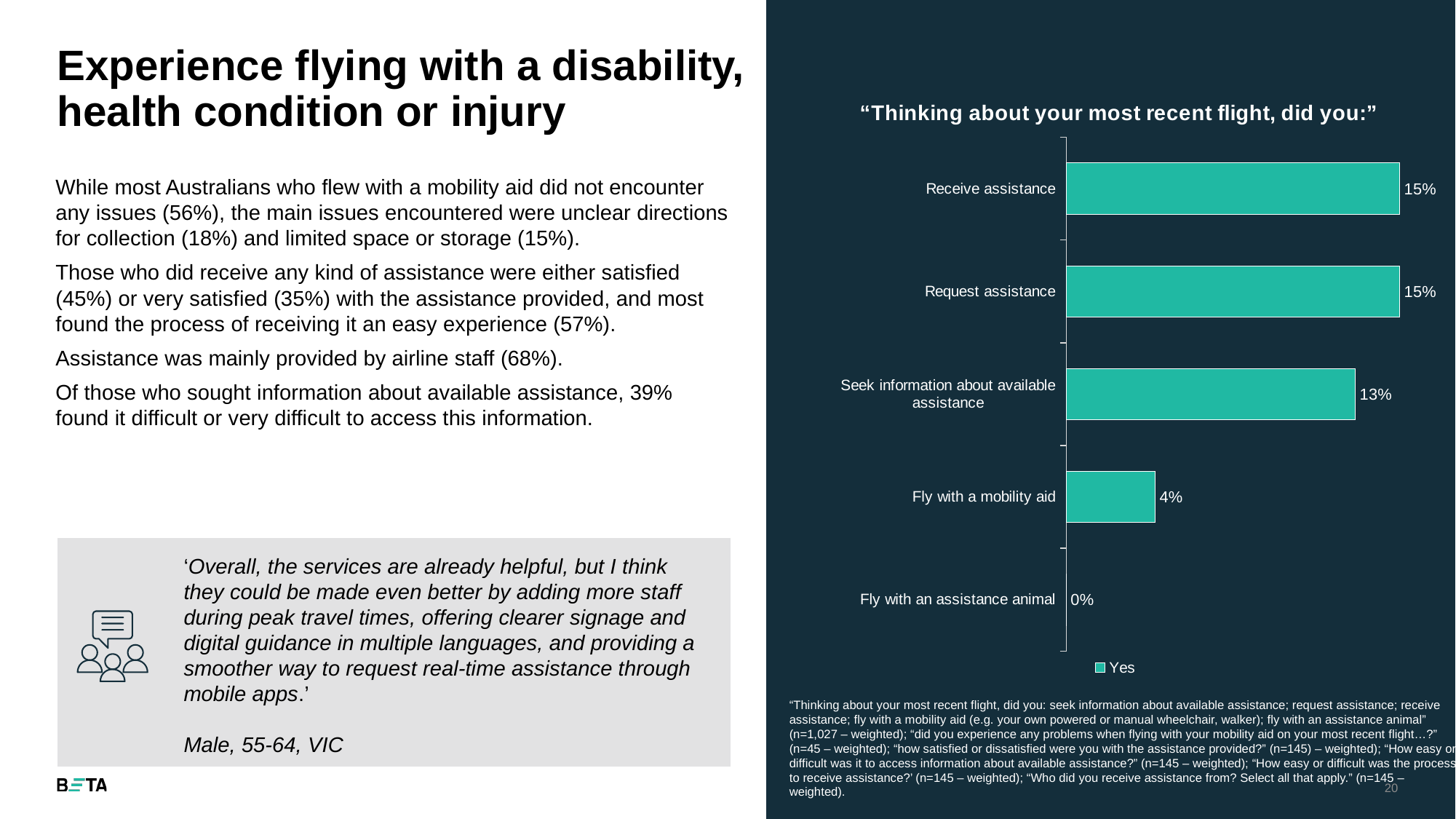
How many categories are shown in the chart? 5 What is the legend entry shown below the chart? Yes Which category has the lowest value in the chart? Fly with an assistance animal How many series does the legend list? 1 What is the difference between the values for 'Request assistance' and 'Fly with a mobility aid'? 11% What kind of chart is shown on the slide? Bar chart What is the title of the chart? "Thinking about your most recent flight, did you:" What percentage of respondents flew with a mobility aid? 4% What is the value for 'Seek information about available assistance'? 13% What is the value shown for 'Fly with an assistance animal'? 0% Which is larger: the value for 'Seek information about available assistance' or 'Fly with a mobility aid'? Seek information about available assistance What percentage of respondents said they received assistance on their most recent flight? 15%